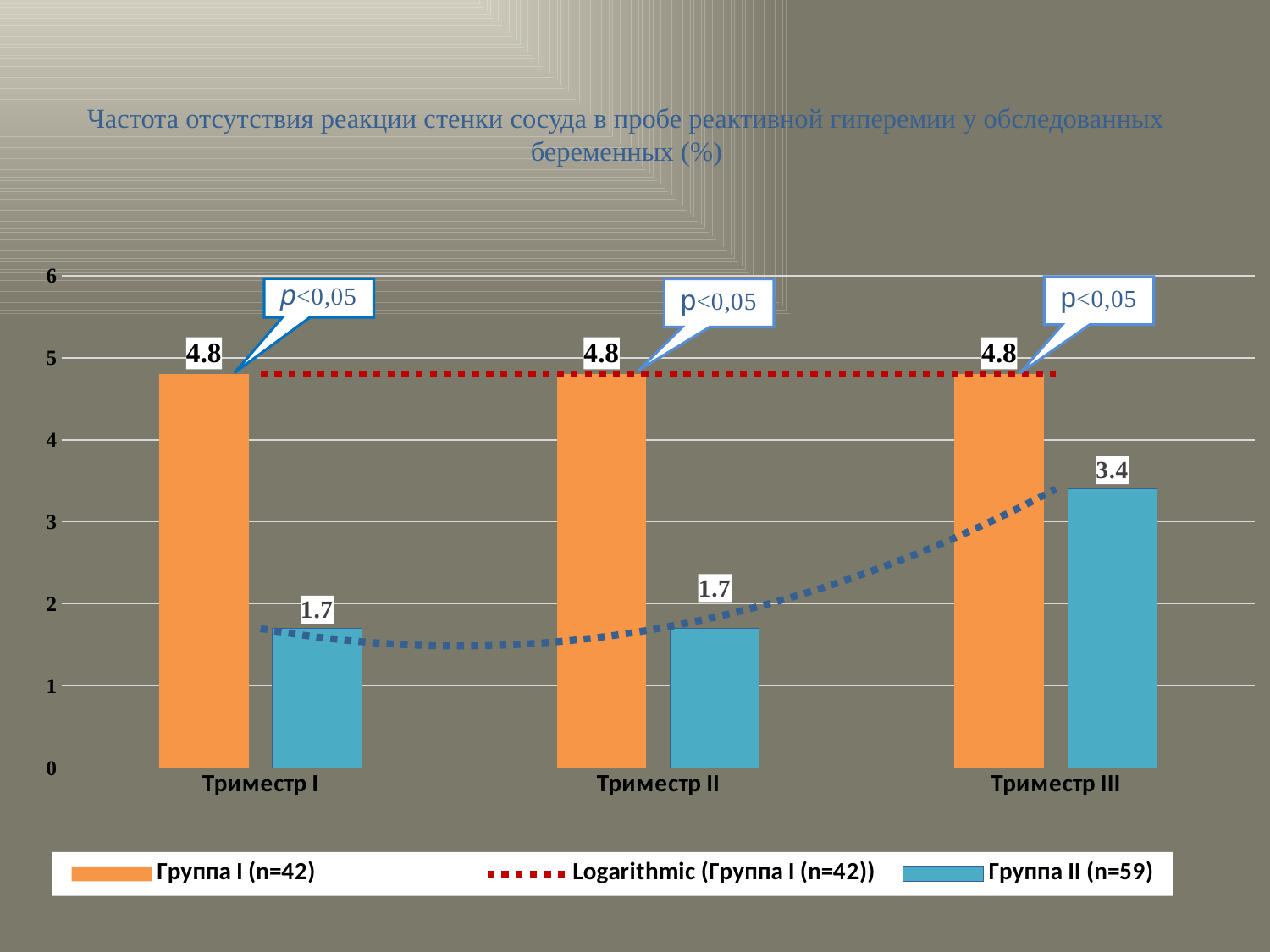
Which is larger in Триместр II: Группа I (n=42) or Группа II (n=59)? Группа I (n=42) What colour are the bars for Группа II (n=59)? Blue What is the difference between Группа I (n=42) and Группа II (n=59) in Триместр III? 1.4 What is the value for Группа I (n=42) in Триместр I? 4.8 How many entries does the legend list? 3 In which trimester is the value for Группа II (n=59) highest? Триместр III Does the value for Группа I (n=42) rise, fall or stay the same across the trimesters? Stays the same What is the difference between Группа I (n=42) and Группа II (n=59) in Триместр I? 3.1 What kind of chart is shown on the slide? Bar chart How many trimester categories are shown on the x axis? 3 What is the value for Группа II (n=59) in Триместр II? 1.7 What is the value for Группа II (n=59) in Триместр III? 3.4